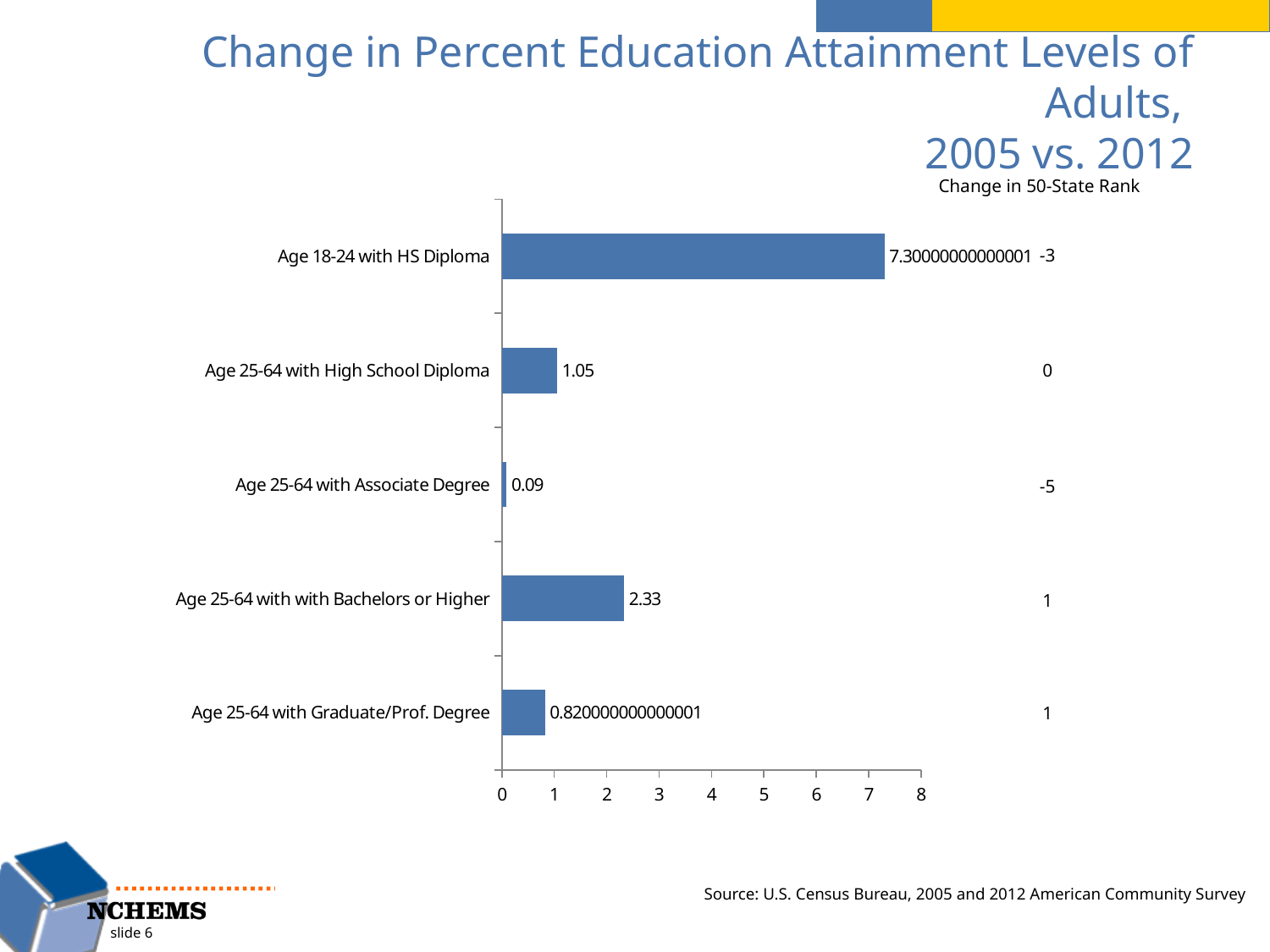
What type of chart is shown on the slide? bar chart What is the value for Age 25-64 with with Bachelors or Higher? 2.33 What is the data label shown for Age 18-24 with HS Diploma? 7.30000000000001 How many categories are plotted in the chart? 5 What is the value for Age 25-64 with High School Diploma? 1.05 Is the value for Age 18-24 with HS Diploma greater or less than 7? greater Which category has the lowest value? Age 25-64 with Associate Degree Which category has the highest value? Age 18-24 with HS Diploma Which is larger: the value for Age 25-64 with with Bachelors or Higher or the value for Age 25-64 with High School Diploma? Age 25-64 with with Bachelors or Higher What is the Change in 50-State Rank shown for Age 25-64 with Associate Degree? -5 What is the value for Age 25-64 with Associate Degree? 0.09 What is the difference between the value for Age 25-64 with with Bachelors or Higher and the value for Age 25-64 with High School Diploma? 1.28